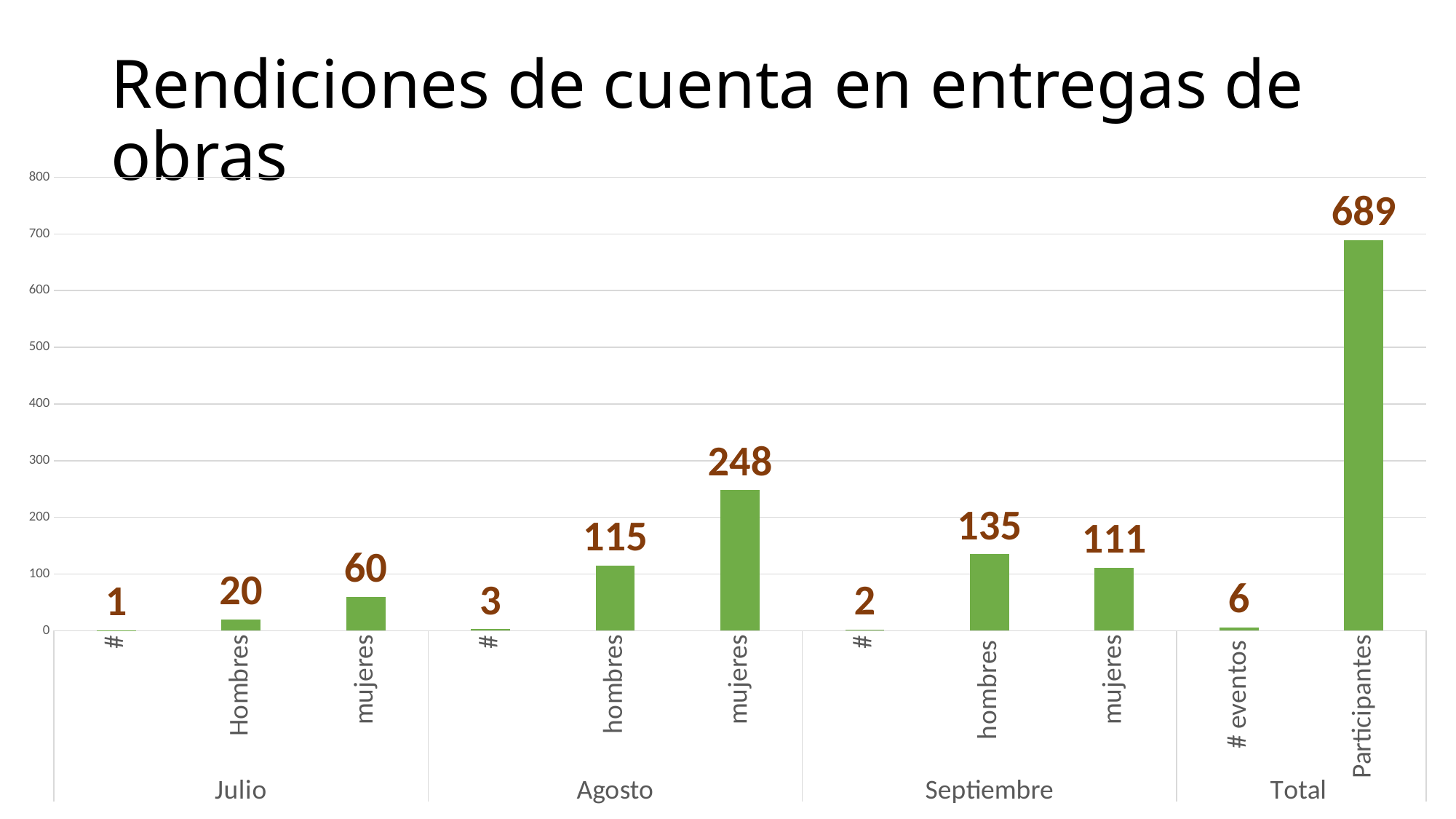
What is the value for mujeres in Agosto? 248 What is the value for Participantes in the Total group? 689 What is the value for hombres in Septiembre? 135 What is the value for # eventos in the Total group? 6 What is the title of the slide? Rendiciones de cuenta en entregas de obras Which bar has the highest value on the chart? Participantes (Total) Which bar has the lowest value on the chart? # (Julio) Which is larger in Septiembre, hombres or mujeres? hombres What is the difference between mujeres and hombres in Agosto? 133 What kind of chart is shown on the slide? bar chart How many bars are plotted on the chart? 11 Is the value for mujeres in Julio greater or less than 100? less